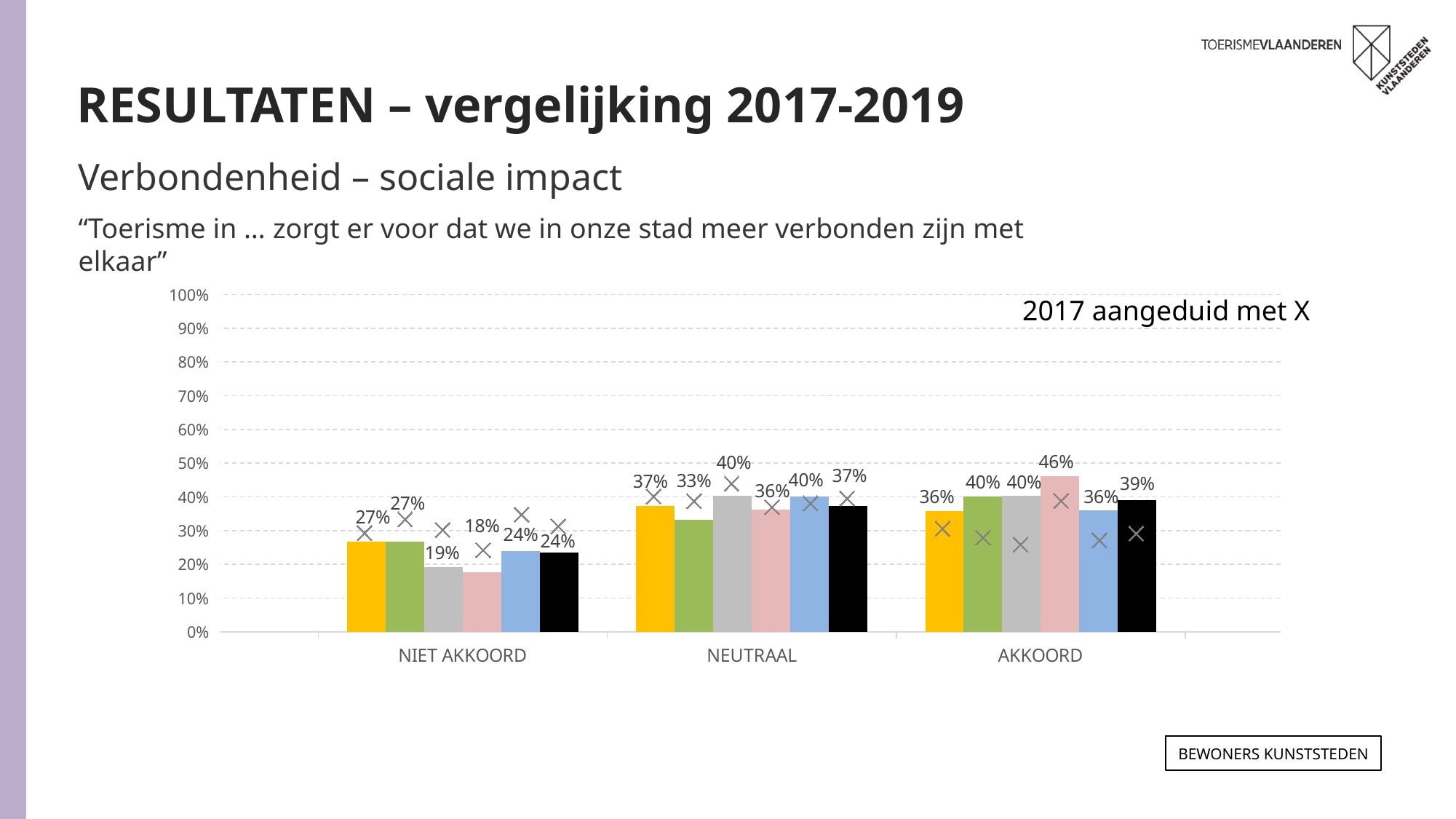
How many bars are plotted in each category of the chart? 6 What kind of chart is shown on the slide? bar chart Which bar has the lowest value in the NIET AKKOORD category? the pink bar (18%) What is the value of the grey bar in the NEUTRAAL category? 40% What is the value of the pink bar in the AKKOORD category? 46% Which bar has the highest value in the AKKOORD category? the pink bar (46%) How many categories are shown on the x axis of the chart? 3 Which is larger: the yellow bar in NEUTRAAL or the yellow bar in NIET AKKOORD? the yellow bar in NEUTRAAL (37%) What is the value of the black bar in the AKKOORD category? 39% What is the difference between the pink bar in AKKOORD (46%) and the pink bar in NIET AKKOORD (18%)? 28 percentage points According to the note on the chart, what symbol marks the 2017 values? X What is the value of the pink bar in the NIET AKKOORD category? 18%